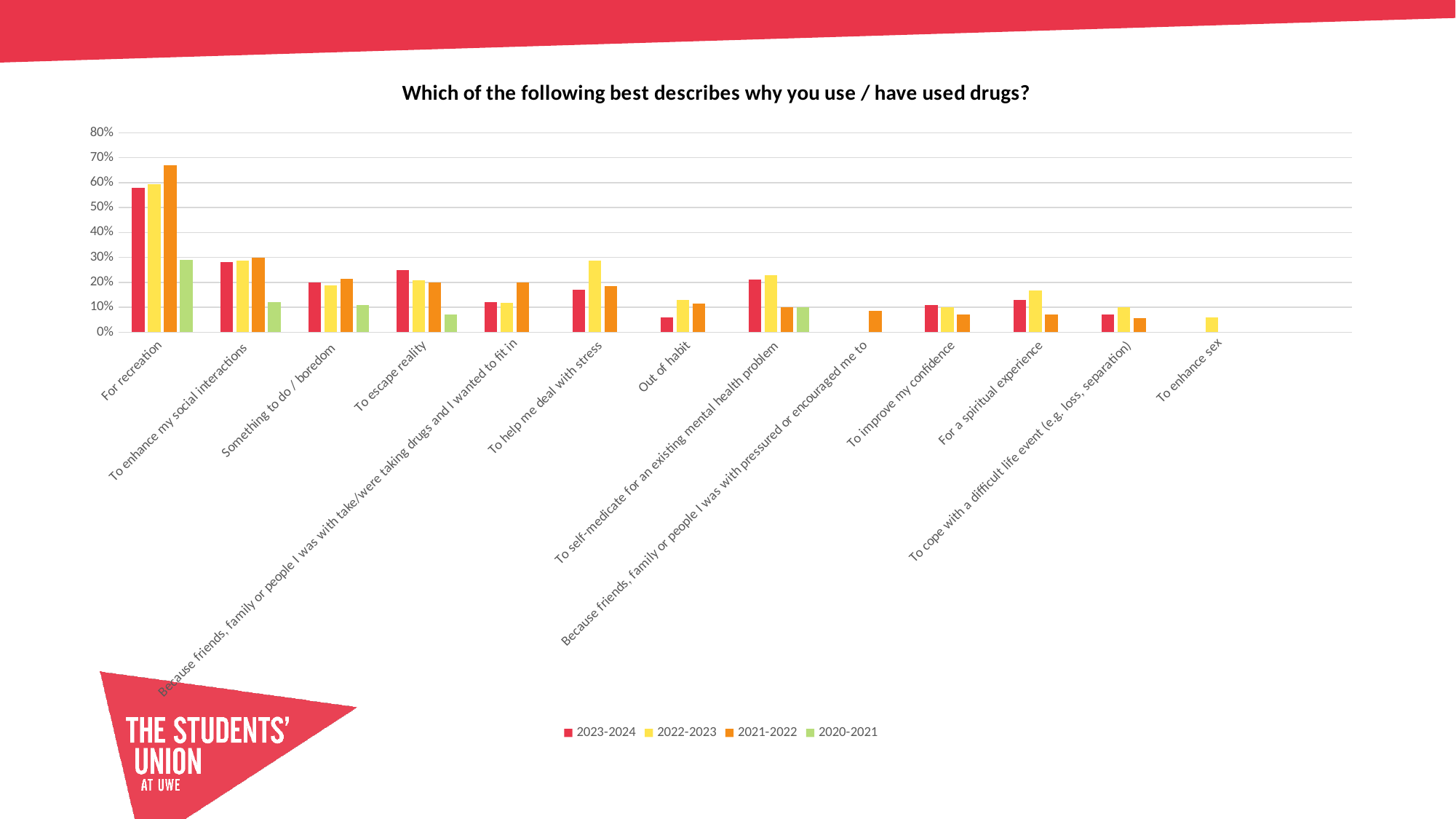
Which category has the highest value for the 2021-2022 series? For recreation Which category has the highest value for the 2022-2023 series? For recreation For 'To escape reality', which is larger: the 2023-2024 value or the 2020-2021 value? 2023-2024 Is the 2022-2023 value for 'To help me deal with stress' greater or less than 20%? greater What kind of chart is shown on the slide? bar chart What is the title of the chart? Which of the following best describes why you use / have used drugs? For 'For recreation', which is larger: the 2021-2022 value or the 2023-2024 value? 2021-2022 How many categories are shown on the x axis? 13 How many series does the legend list? 4 Is the 2020-2021 value for 'To enhance my social interactions' greater or less than 20%? less Is the 2023-2024 value for 'Out of habit' greater or less than 10%? less